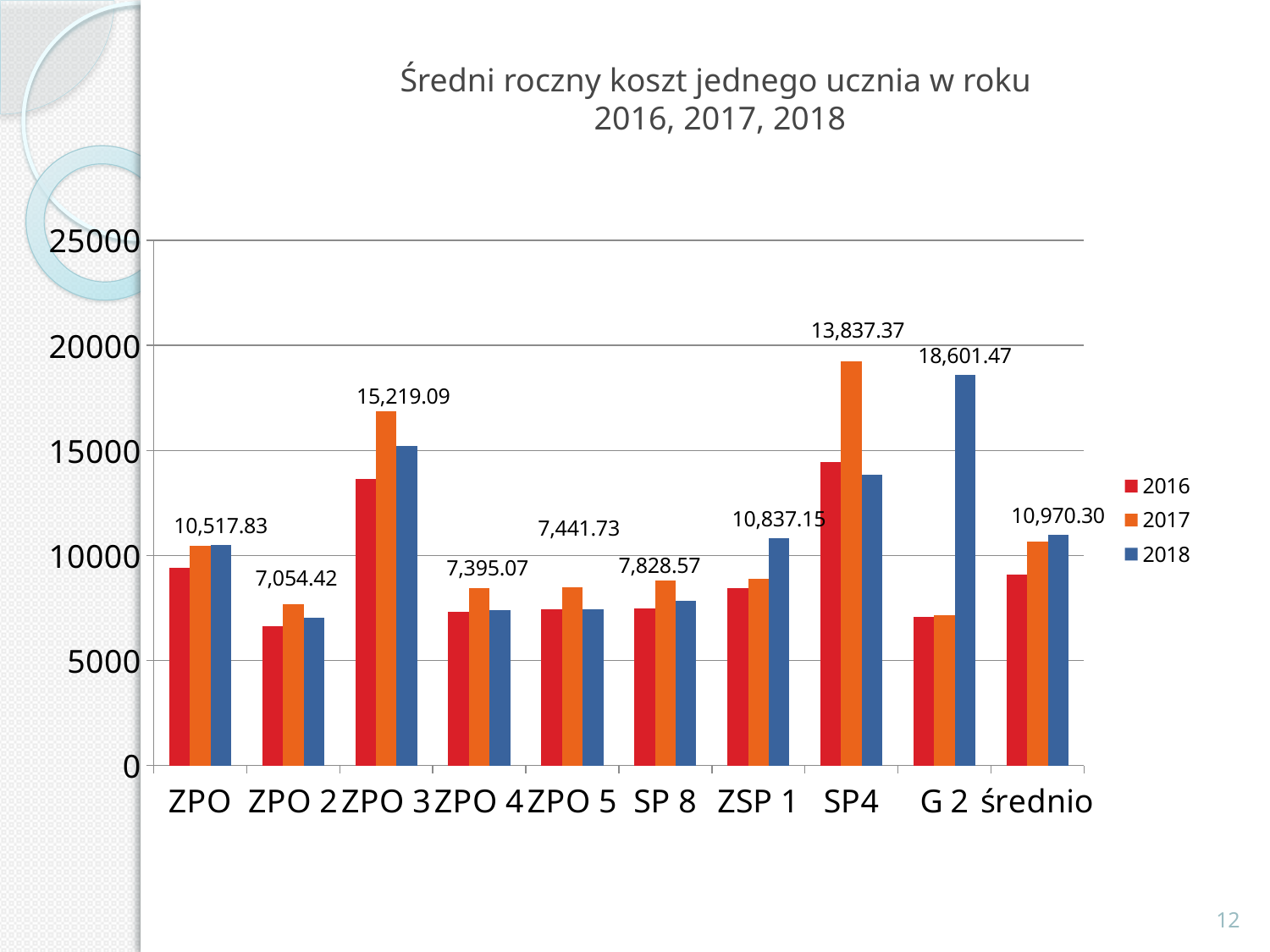
What is the 2018 value for the 'średnio' category? 10,970.30 How many categories are shown on the x axis? 10 What is the value for G 2 in the 2018 series? 18,601.47 Is the 2017 value for SP4 greater or less than 15000? greater What is the value for ZPO 3 in the 2018 series? 15,219.09 Which category has the highest 2018 value? G 2 What is the value for SP 8 in 2018? 7,828.57 What is the difference between the 2018 values for G 2 and ZPO 2? 11,547.05 How many series does the legend list? 3 What kind of chart is shown on the slide? bar chart Which category has the lowest 2018 value? ZPO 2 Which is larger in 2018: the value for ZSP 1 or the value for ZPO? ZSP 1